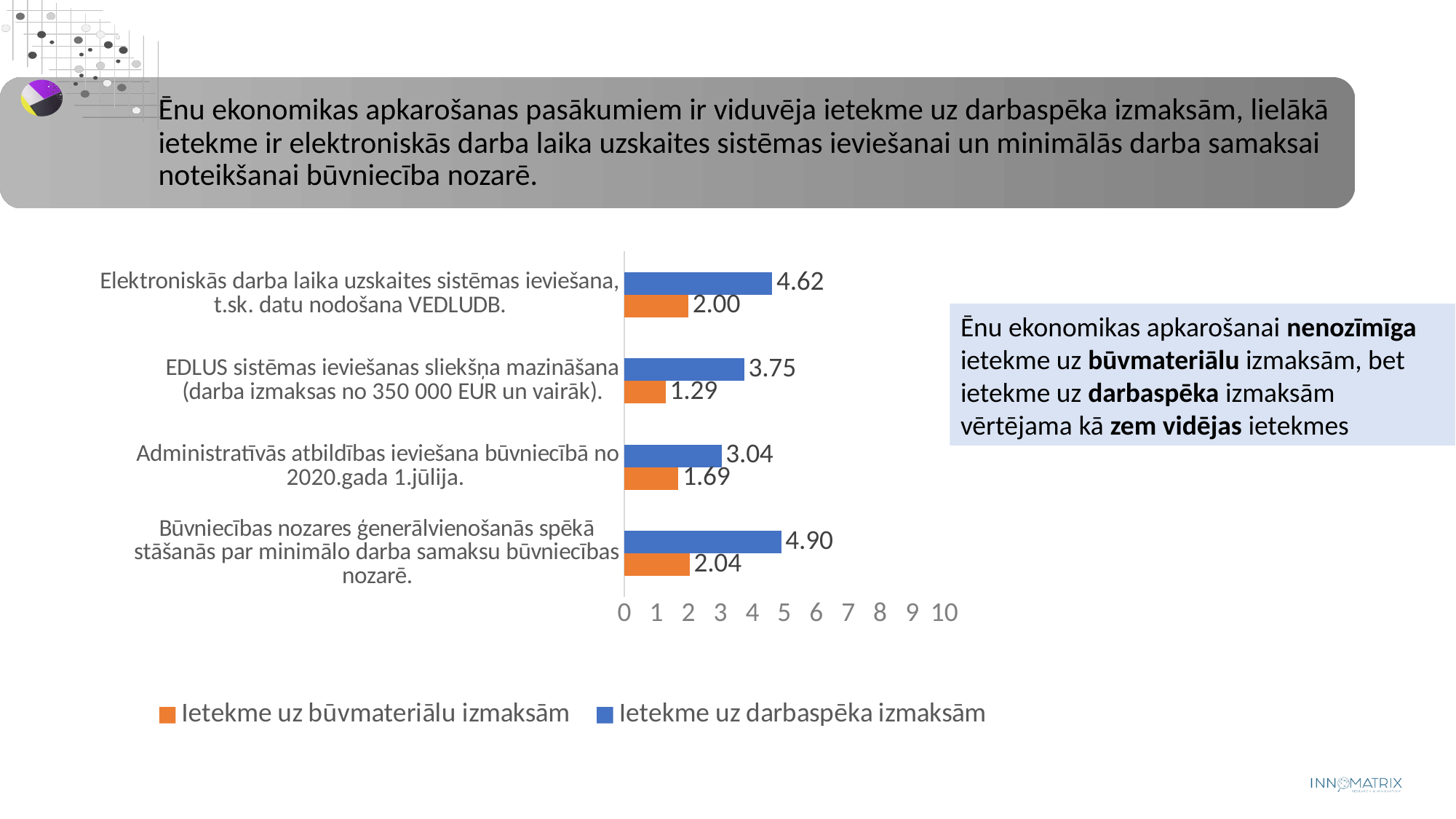
Which colour represents 'Ietekme uz būvmateriālu izmaksām' in the chart? orange What is the value of 'Ietekme uz būvmateriālu izmaksām' for 'EDLUS sistēmas ieviešanas sliekšņa mazināšana (darba izmaksas no 350 000 EUR un vairāk).'? 1.29 What kind of chart is shown on the slide? bar chart How many categories are shown on the chart? 4 What is the value of 'Ietekme uz darbaspēka izmaksām' for 'Elektroniskās darba laika uzskaites sistēmas ieviešana, t.sk. datu nodošana VEDLUDB.'? 4.62 Which category has the highest value for 'Ietekme uz darbaspēka izmaksām'? Būvniecības nozares ģenerālvienošanās spēkā stāšanās par minimālo darba samaksu būvniecības nozarē. Is the value of 'Ietekme uz darbaspēka izmaksām' for 'Elektroniskās darba laika uzskaites sistēmas ieviešana' greater or less than 5? less Which is larger: 'Ietekme uz darbaspēka izmaksām' for 'EDLUS sistēmas ieviešanas sliekšņa mazināšana' or for 'Administratīvās atbildības ieviešana būvniecībā no 2020.gada 1.jūlija.'? EDLUS sistēmas ieviešanas sliekšņa mazināšana What is the value of 'Ietekme uz darbaspēka izmaksām' for 'Administratīvās atbildības ieviešana būvniecībā no 2020.gada 1.jūlija.'? 3.04 How many series does the legend list? 2 What is the difference between 'Ietekme uz darbaspēka izmaksām' and 'Ietekme uz būvmateriālu izmaksām' for 'Būvniecības nozares ģenerālvienošanās spēkā stāšanās par minimālo darba samaksu būvniecības nozarē.'? 2.86 Which category has the lowest value for 'Ietekme uz būvmateriālu izmaksām'? EDLUS sistēmas ieviešanas sliekšņa mazināšana (darba izmaksas no 350 000 EUR un vairāk).